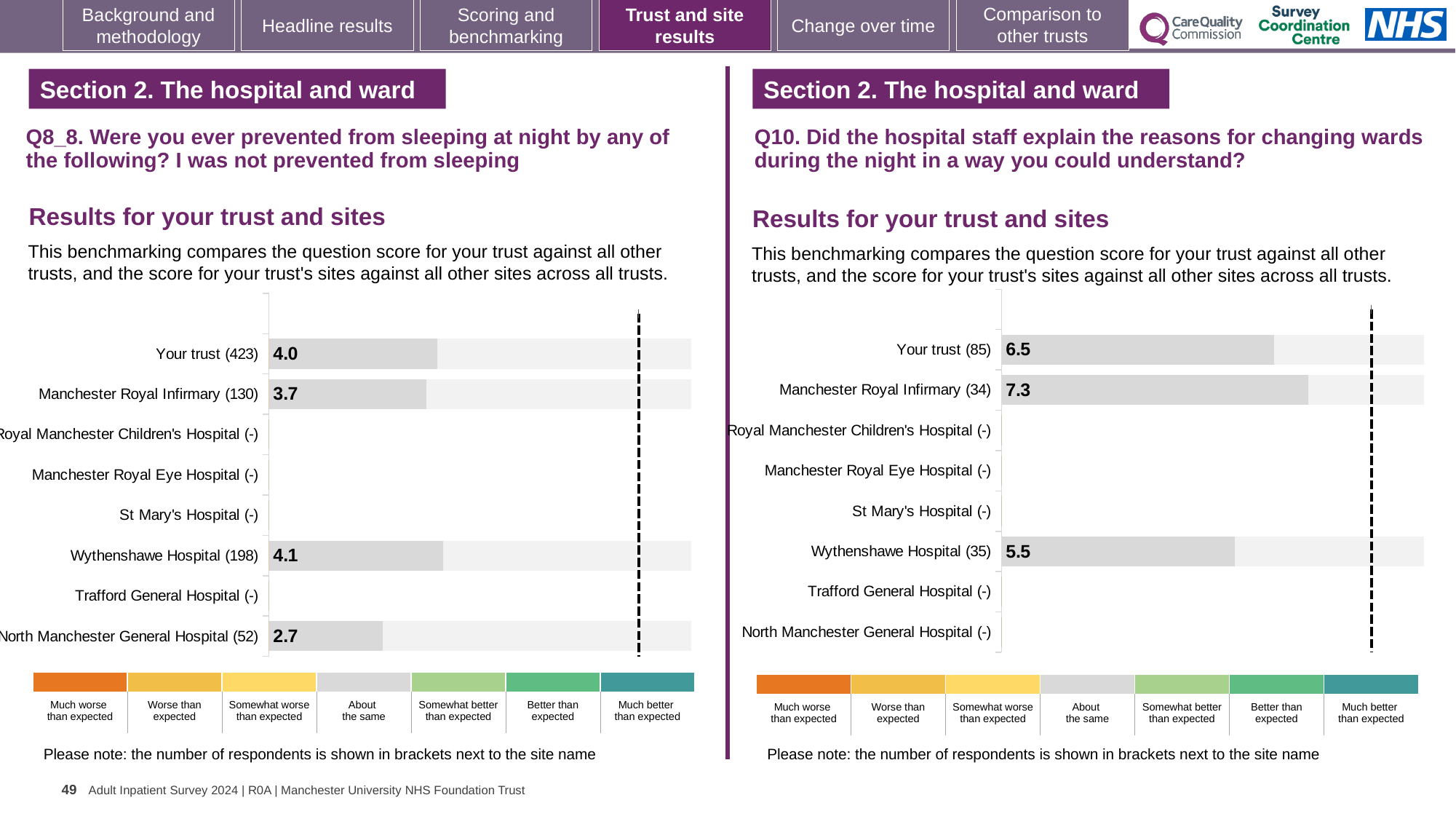
In the Q8_8 chart on the left, what is the difference between the scores for Wythenshawe Hospital and North Manchester General Hospital? 1.4 In the Q10 chart on the right, how many respondents are shown in brackets for Your trust? 85 In the Q10 chart on the right, what is the score for Manchester Royal Infirmary? 7.3 In the Q10 chart on the right, what is the difference between the scores for Manchester Royal Infirmary and Wythenshawe Hospital? 1.8 In the Q8_8 chart on the left, how many sites have a score shown as a bar? 3 In the Q10 chart on the right, what is the score for Wythenshawe Hospital? 5.5 In the Q8_8 chart on the left, what is the score for North Manchester General Hospital? 2.7 In the Q8_8 chart on the left, which site has the highest score? Wythenshawe Hospital In the Q8_8 chart on the left, which site has the lowest score? North Manchester General Hospital In the Q10 chart on the right, which is larger, the score for Your trust or for Manchester Royal Infirmary? Manchester Royal Infirmary What kind of chart is used on the left for Q8_8? Bar chart In the Q8_8 chart on the left, what is the score for Your trust? 4.0